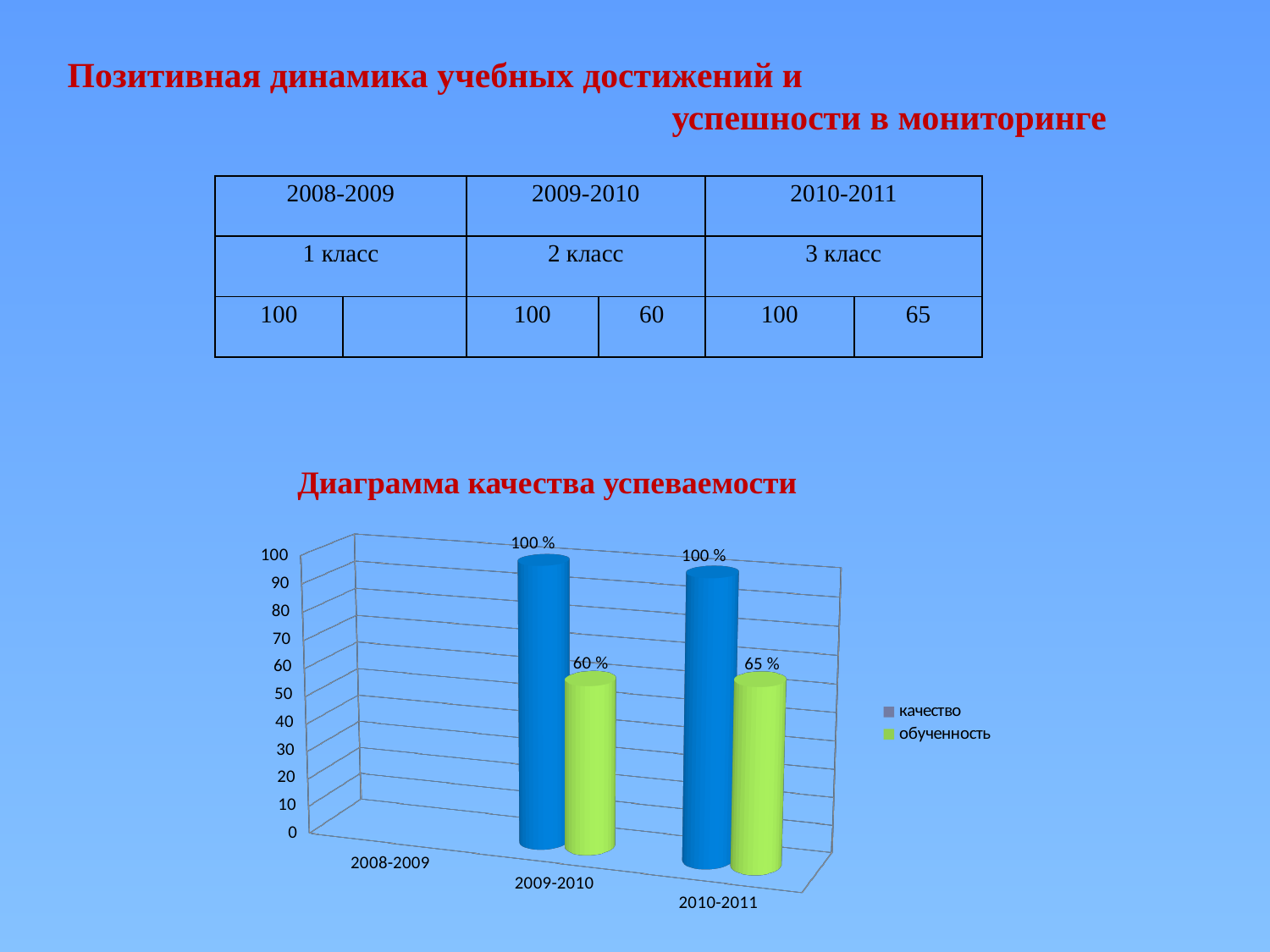
What is the value for качество in 2010-2011? 100 % Which year has the higher value for обученность, 2009-2010 or 2010-2011? 2010-2011 What is the difference between the обученность values for 2010-2011 and 2009-2010? 5 % What is the title of the chart? Диаграмма качества успеваемости What is the value for качество in 2009-2010? 100 % What is the value for обученность in 2009-2010? 60 % What kind of chart is shown on the slide? bar chart How many series does the legend list? 2 Does the value for обученность rise or fall from 2009-2010 to 2010-2011? rise What is the value for обученность in 2010-2011? 65 % What is the difference between качество and обученность in 2009-2010? 40 % How many categories are shown on the x axis? 3